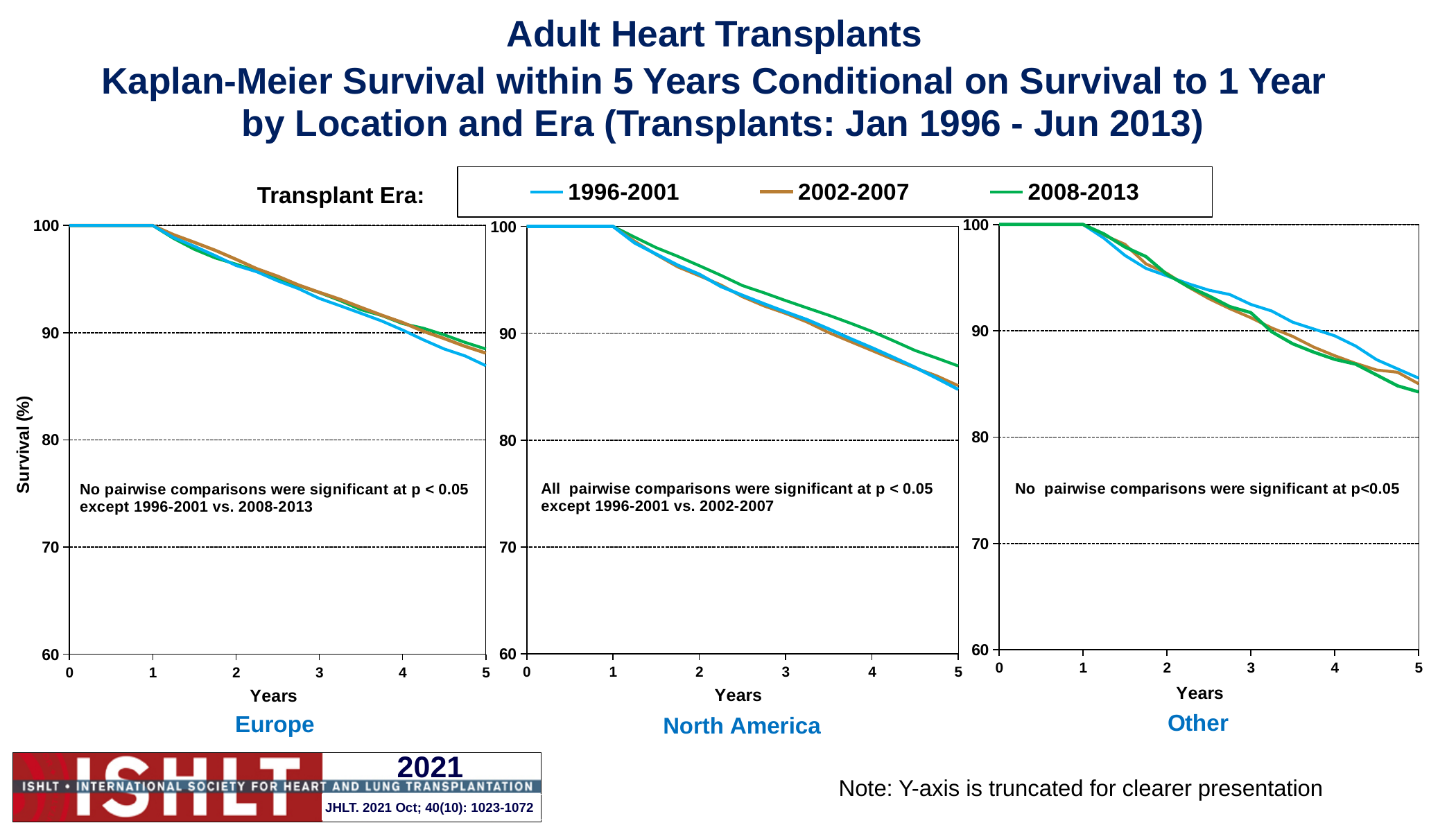
In the North America chart, at year 5, which era has higher survival: 1996-2001 or 2008-2013? 2008-2013 In the Other chart, is the survival value for 2008-2013 at year 5 greater or less than 90? less In the North America chart, which era has the highest survival at year 5? 2008-2013 In the Europe chart, is the survival value for 1996-2001 at year 5 greater or less than 90? less How many location panels (charts) are shown on the slide? 3 In the Europe chart, do the survival curves rise or fall as years increase from 1 to 5? fall In the North America chart, is the survival value for 2008-2013 at year 5 greater or less than 90? less In the North America chart, what is the survival value for all eras at year 0? 100 How many transplant eras does the legend list? 3 What kind of chart is used for the Europe panel? line chart What is the label of the y-axis on the Europe chart? Survival (%)